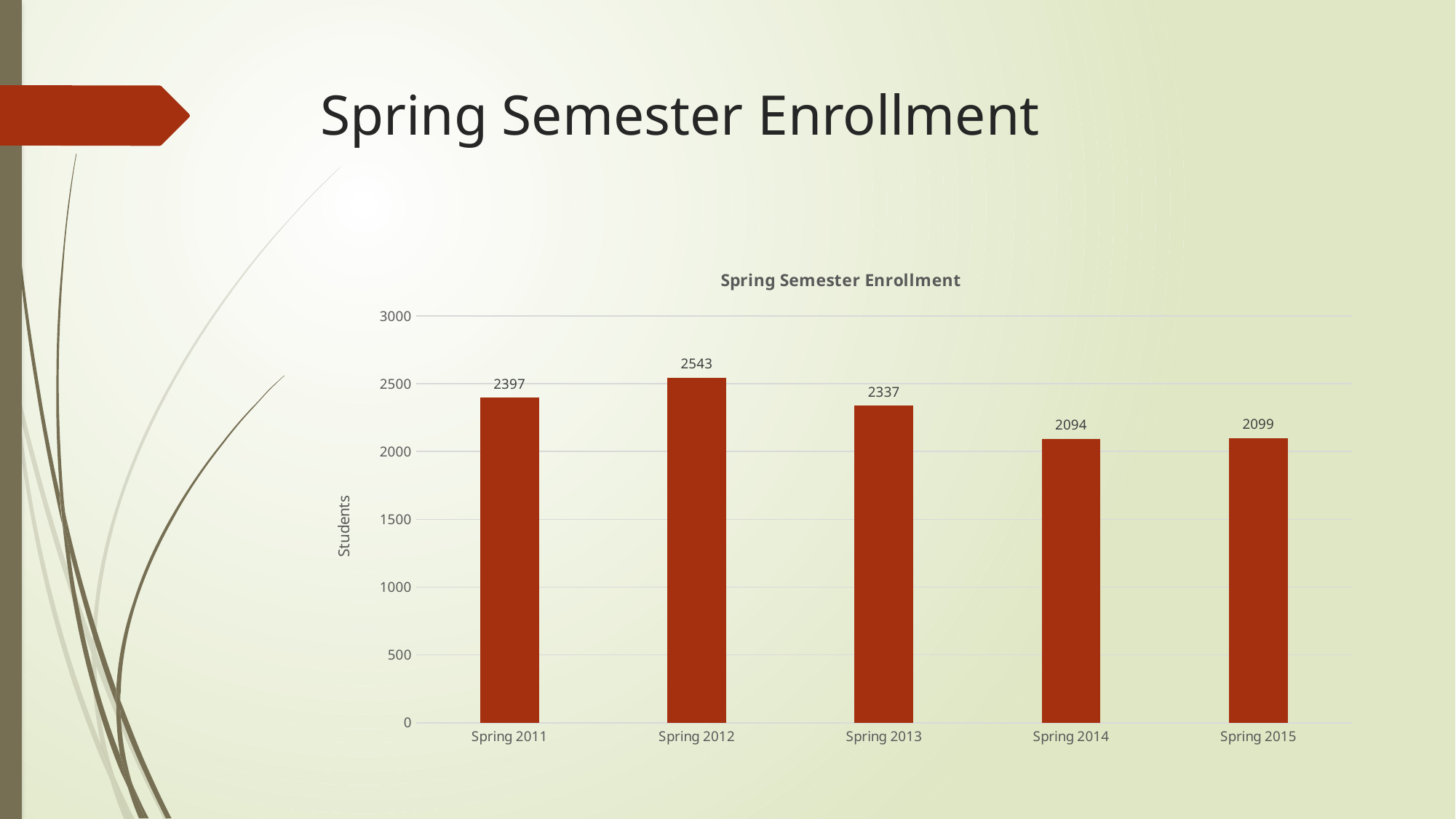
How many semesters are shown on the chart? 5 Is the enrollment for Spring 2013 greater or less than 2500? less What is the enrollment for Spring 2012? 2543 What is the difference in enrollment between Spring 2011 and Spring 2015? 298 Which has a larger enrollment, Spring 2011 or Spring 2013? Spring 2011 What is the enrollment for Spring 2011? 2397 What kind of chart is shown on the slide? bar chart What is the difference in enrollment between Spring 2012 and Spring 2013? 206 Which semester has the lowest enrollment? Spring 2014 What is the label on the vertical axis of the chart? Students Which semester has the highest enrollment? Spring 2012 What is the enrollment for Spring 2014? 2094